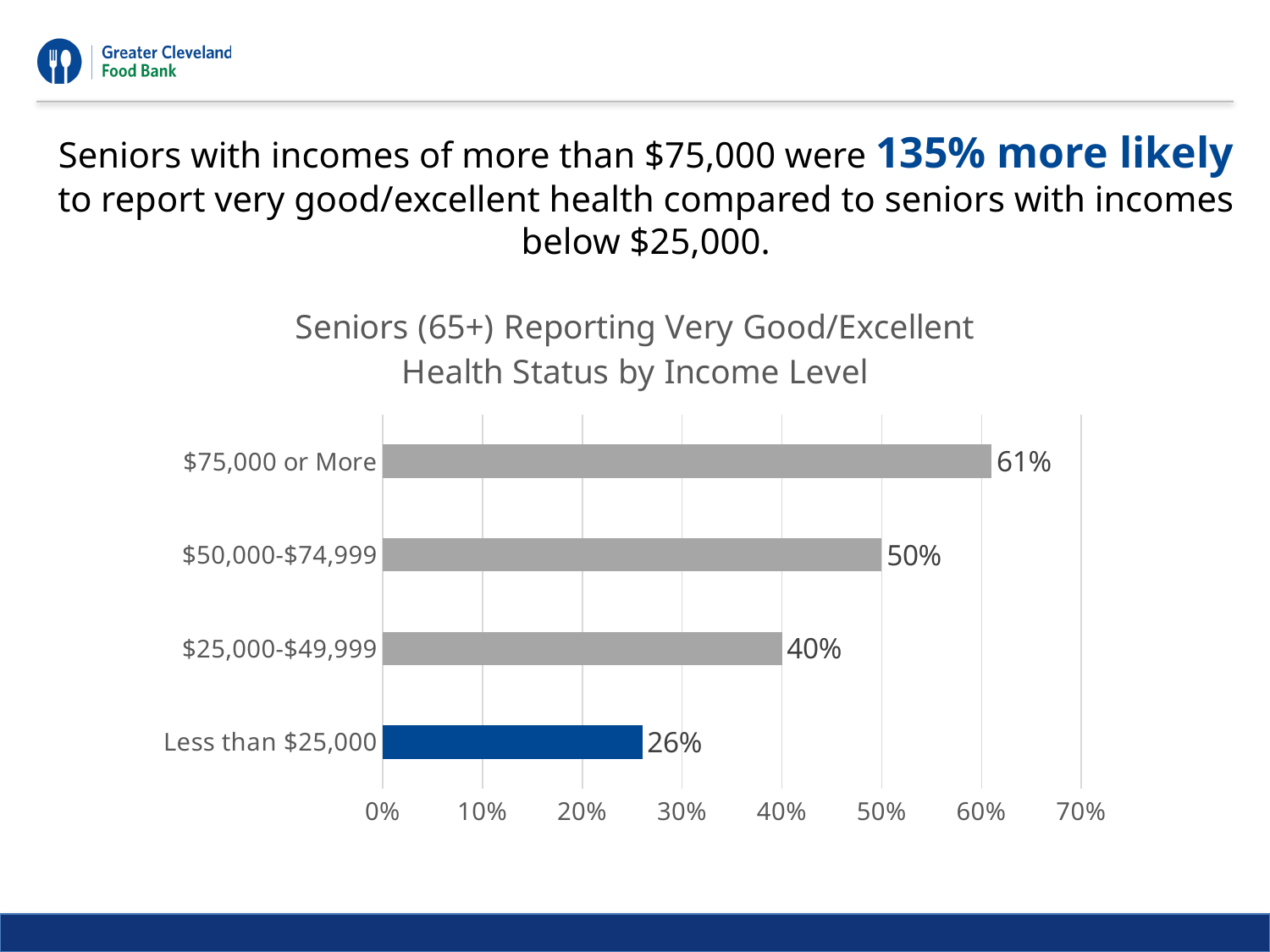
What percentage of seniors with incomes less than $25,000 reported very good/excellent health? 26% Which bar is coloured blue rather than grey? Less than $25,000 How many income levels are shown in the chart? 4 What is the difference in percentage points between the $75,000 or More group and the Less than $25,000 group? 35 percentage points What percentage of seniors with incomes of $75,000 or more reported very good/excellent health? 61% Is the value for Less than $25,000 greater or less than 30%? less What is the value for the $25,000-$49,999 income level? 40% Which is larger: the value for $50,000-$74,999 or the value for $25,000-$49,999? $50,000-$74,999 Which income level has the lowest share of seniors reporting very good/excellent health? Less than $25,000 Which income level has the highest share of seniors reporting very good/excellent health? $75,000 or More What type of chart is shown on the slide? Bar chart What is the value for the $50,000-$74,999 income level? 50%